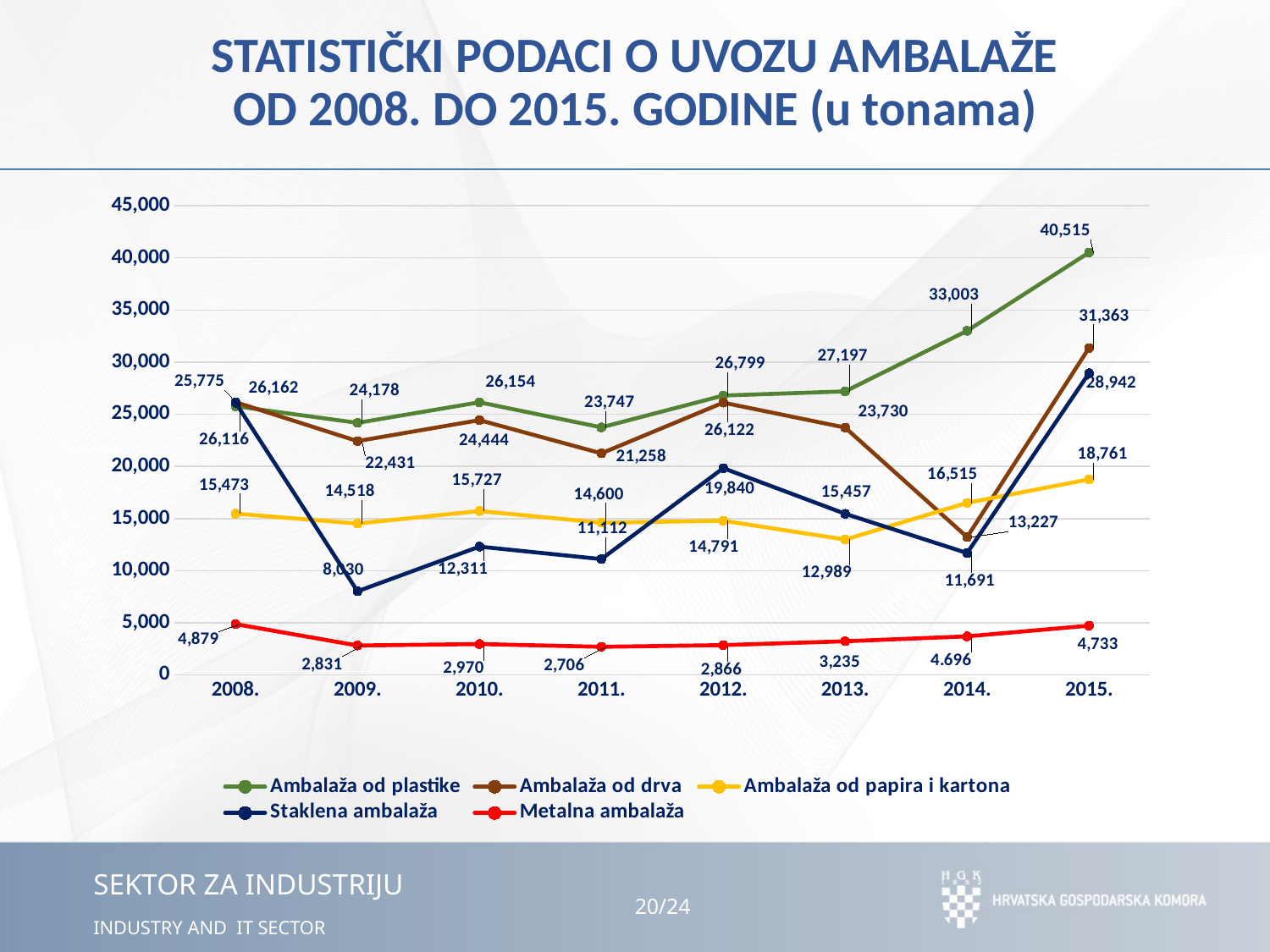
In which year was Staklena ambalaža at its lowest? 2009. What was the value for Ambalaža od plastike in 2015? 40,515 In 2014, which was larger: Ambalaža od drva or Staklena ambalaža? Ambalaža od drva What kind of chart is shown on the slide? line chart How many years are shown on the x axis? 8 By how much did Ambalaža od plastike increase from 2014 to 2015? 7,512 In which year was Ambalaža od plastike at its highest? 2015. What was the value for Staklena ambalaža in 2012? 19,840 What was the value for Metalna ambalaža in 2008? 4,879 What was the value for Ambalaža od papira i kartona in 2015? 18,761 Is the value for Ambalaža od plastike in 2014 greater or less than 30,000? greater How many series does the legend list? 5